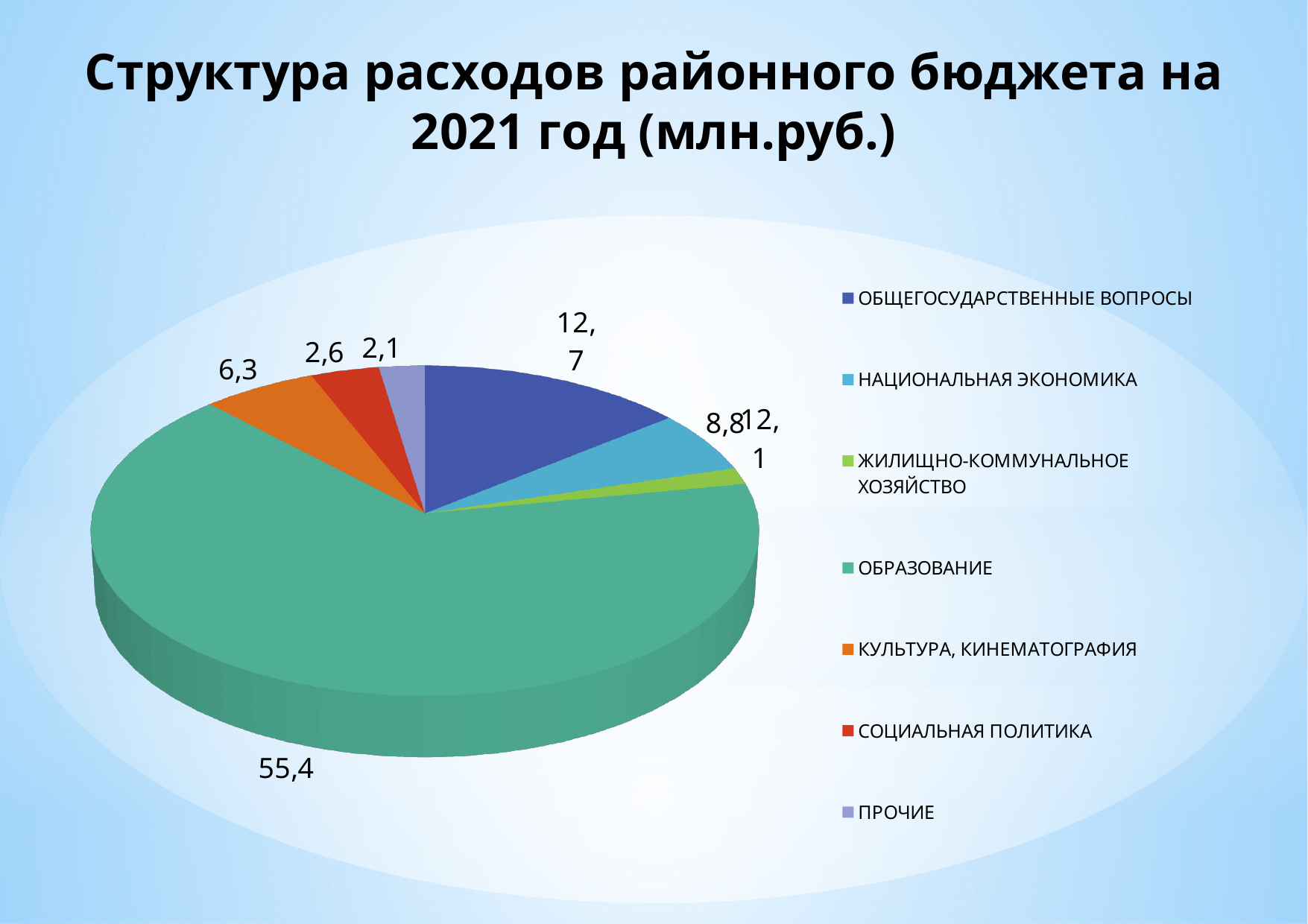
What is the value shown for КУЛЬТУРА, КИНЕМАТОГРАФИЯ? 6,3 Which category has the largest slice of the pie? ОБРАЗОВАНИЕ Which is larger, the value for КУЛЬТУРА, КИНЕМАТОГРАФИЯ or the value for СОЦИАЛЬНАЯ ПОЛИТИКА? КУЛЬТУРА, КИНЕМАТОГРАФИЯ What is the value shown for НАЦИОНАЛЬНАЯ ЭКОНОМИКА? 8,8 What is the value shown for ОБРАЗОВАНИЕ? 55,4 What kind of chart is shown on the slide? Pie chart How many categories does the legend of the pie chart list? 7 What is the difference between the values for ОБЩЕГОСУДАРСТВЕННЫЕ ВОПРОСЫ and НАЦИОНАЛЬНАЯ ЭКОНОМИКА? 3,9 What is the title of the chart on the slide? Структура расходов районного бюджета на 2021 год (млн.руб.) What is the value shown for ОБЩЕГОСУДАРСТВЕННЫЕ ВОПРОСЫ? 12,7 What is the value shown for ПРОЧИЕ? 2,1 What is the value shown for СОЦИАЛЬНАЯ ПОЛИТИКА? 2,6